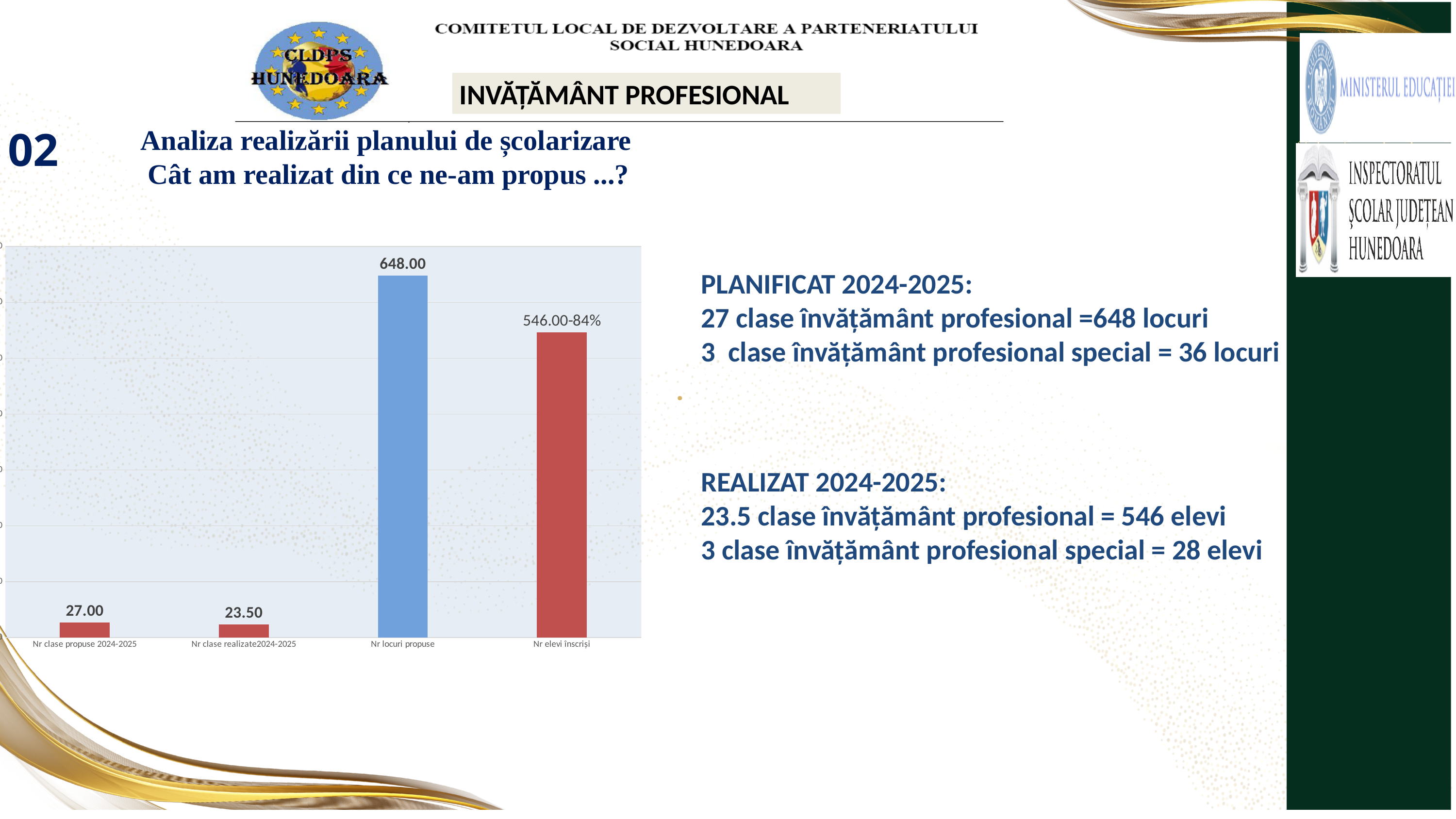
Which category has the highest value? Nr locuri propuse Which is larger, Nr clase propuse 2024-2025 or Nr clase realizate2024-2025? Nr clase propuse 2024-2025 Which category has the lowest value? Nr clase realizate2024-2025 What is the difference between Nr locuri propuse and Nr elevi înscriși? 102.00 What is the data label shown on the Nr elevi înscriși bar? 546.00-84% What is the difference between Nr clase propuse 2024-2025 and Nr clase realizate2024-2025? 3.50 What is the value for Nr clase propuse 2024-2025? 27.00 How many bars (categories) does the chart show? 4 What colour is the Nr locuri propuse bar? blue What is the value for Nr locuri propuse? 648.00 What type of chart is shown on the slide? bar chart What is the value for Nr clase realizate2024-2025? 23.50